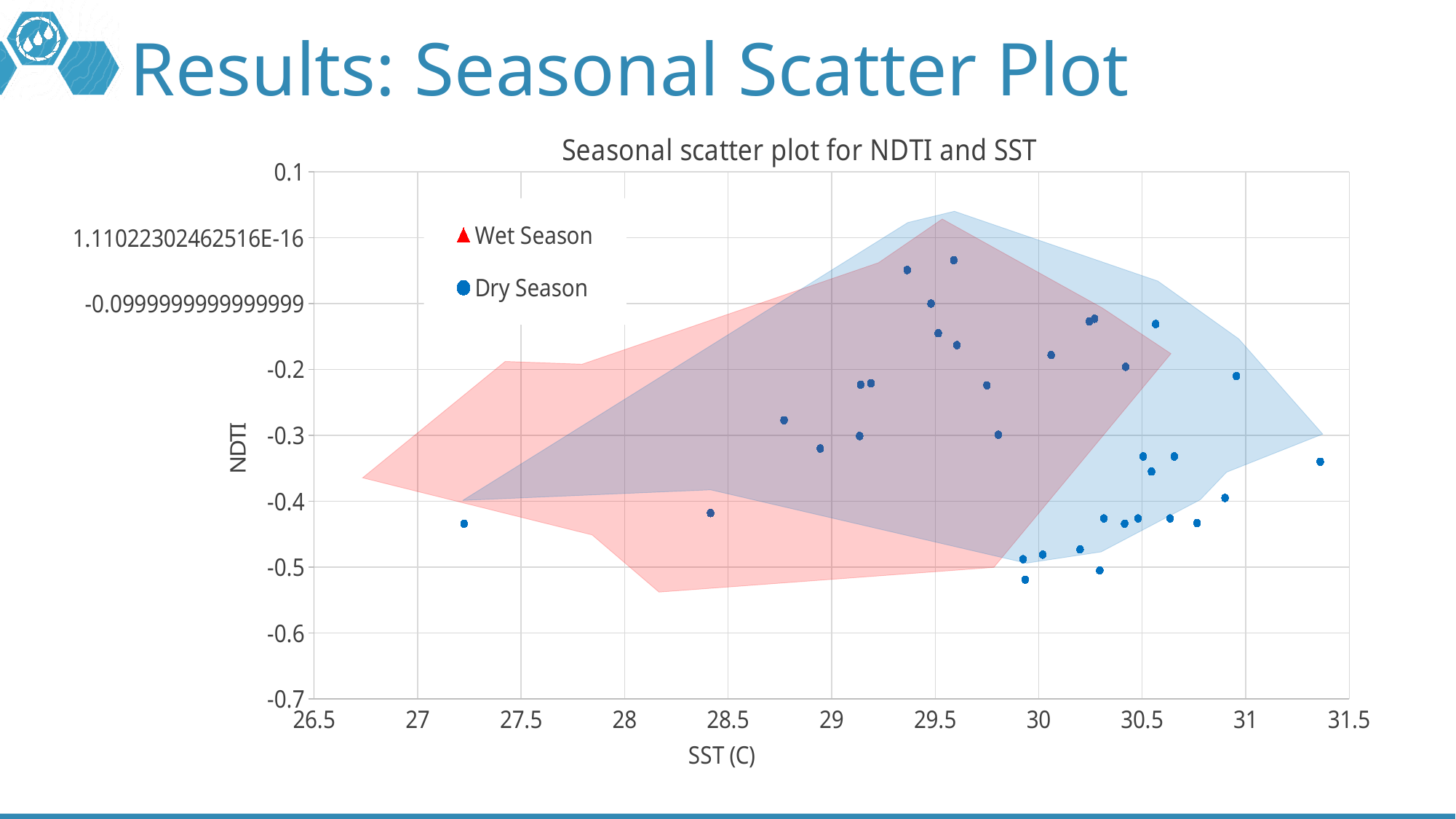
Is the SST of the rightmost Dry Season point greater or less than 31? greater Is the SST of the leftmost Dry Season point greater or less than 27.5? less What kind of chart is shown on the slide? Scatter plot Is the NDTI of the lowest Dry Season point greater or less than -0.6? greater How many series does the legend list? 2 What is the label of the x axis? SST (C) What is the title of the chart? Seasonal scatter plot for NDTI and SST